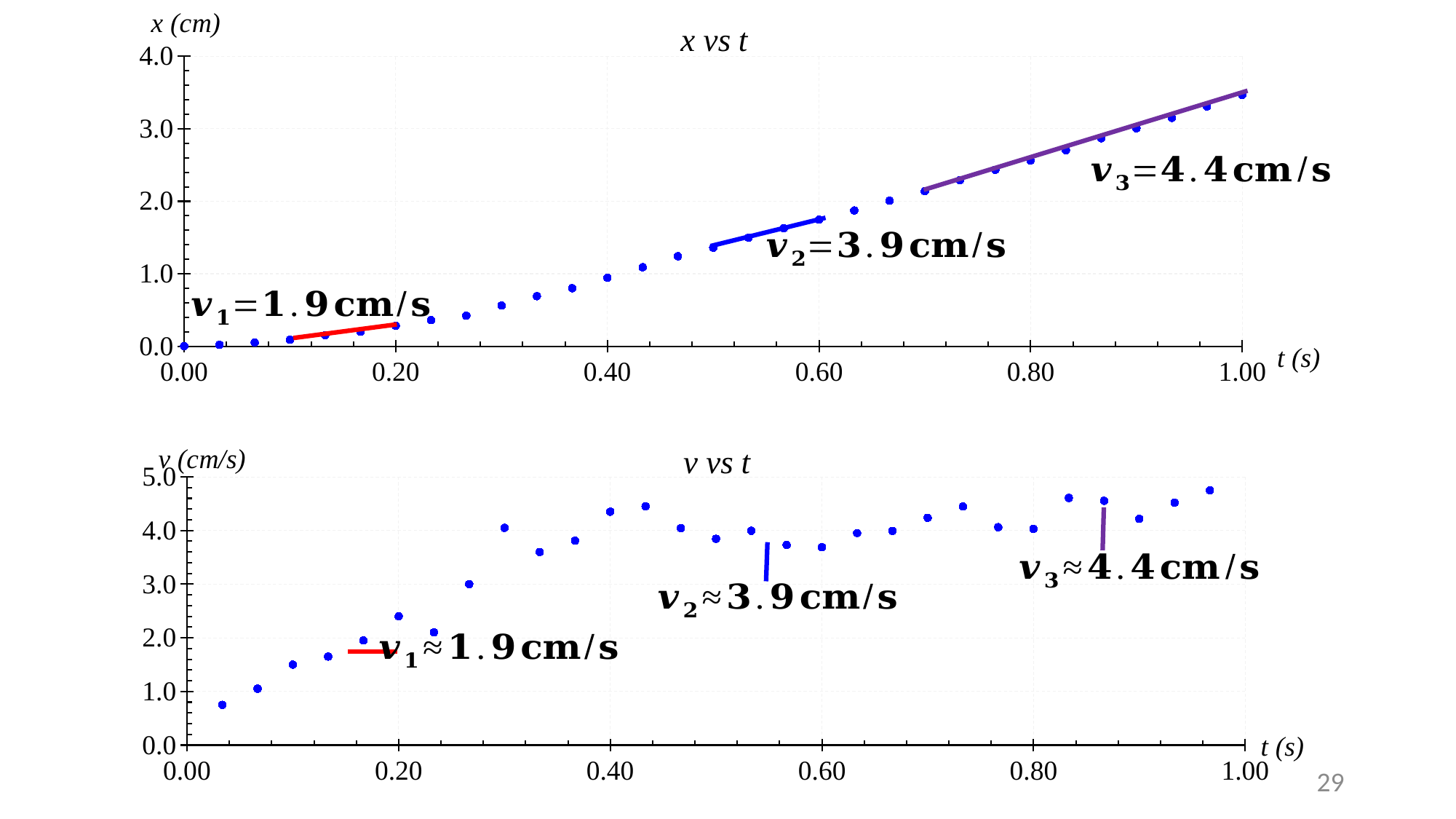
In the "v vs t" chart, which is larger, v2 or v3? v3 In the "x vs t" chart, what is the difference between v3 and v1? 2.5 cm/s In the "x vs t" chart, do the plotted values rise or fall as t increases? rise In the "x vs t" chart, what is the value of v3 given in the annotation? 4.4 cm/s In the "x vs t" chart, is the value of x at t = 1.00 s greater or less than 3.0? greater In the "v vs t" chart, which of the three annotated velocities is the largest? v3 In the "x vs t" chart, what is the value of v2 given in the annotation? 3.9 cm/s In the "v vs t" chart, is the value of v at t = 0.40 s greater or less than 4.0? greater What is the label of the vertical axis of the "v vs t" chart? v (cm/s) In the "v vs t" chart, which of the three annotated velocities is the smallest? v1 What kind of chart is the "x vs t" chart? scatter chart In the "x vs t" chart, what is the value of v1 given in the annotation? 1.9 cm/s